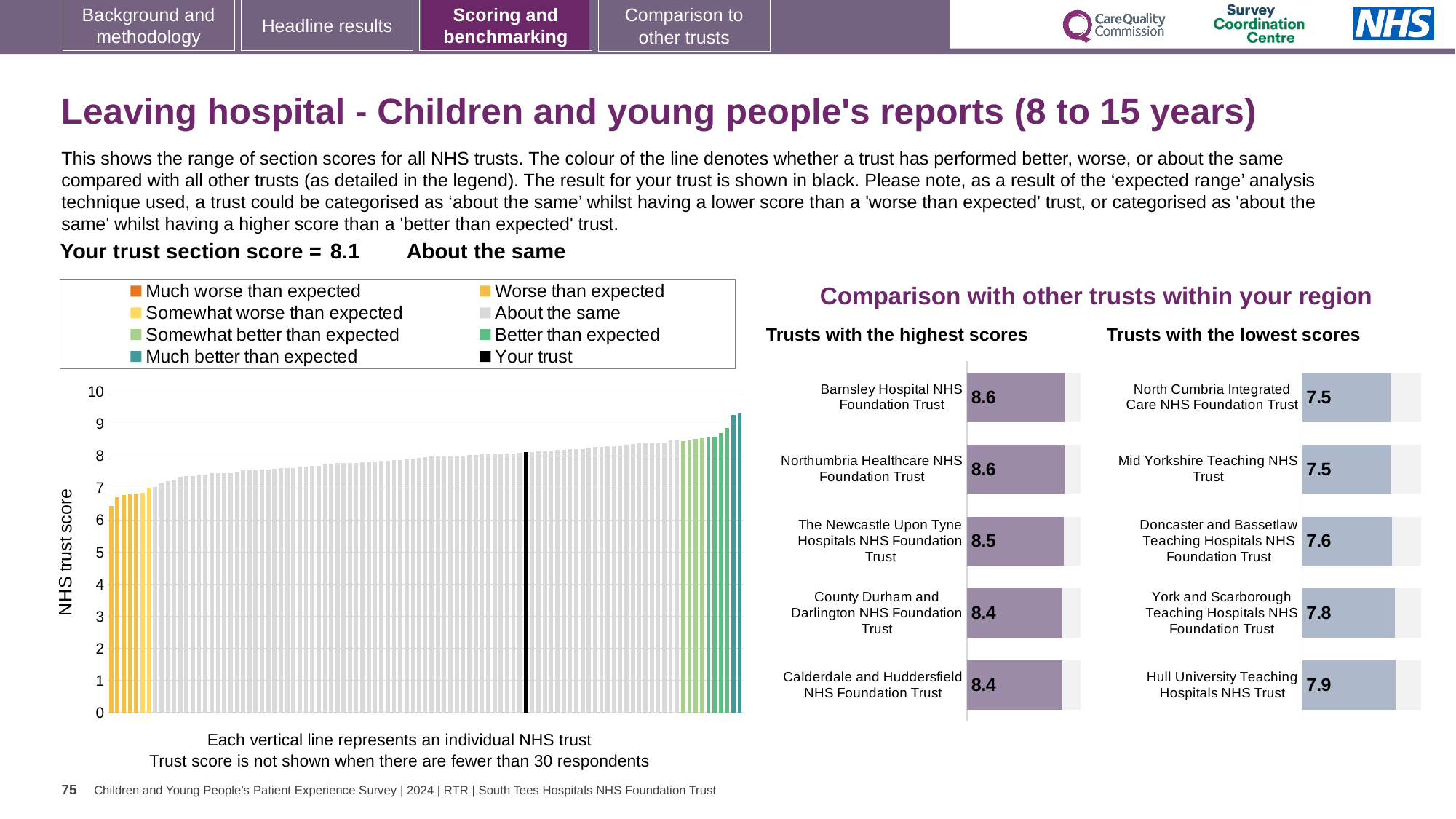
In the large chart on the left showing all NHS trusts, what is the section score for your trust (the black line)? 8.1 In the large chart on the left showing all NHS trusts, do the values rise or fall from left to right? rise In the 'Trusts with the lowest scores' chart, what is the score for York and Scarborough Teaching Hospitals NHS Foundation Trust? 7.8 In the large chart on the left showing all NHS trusts, is the value of the lowest bar greater or less than 7? less In the 'Trusts with the lowest scores' chart, which trust has the highest score? Hull University Teaching Hospitals NHS Trust In the 'Trusts with the lowest scores' chart, which has the larger score: Doncaster and Bassetlaw Teaching Hospitals NHS Foundation Trust or York and Scarborough Teaching Hospitals NHS Foundation Trust? York and Scarborough Teaching Hospitals NHS Foundation Trust In the 'Trusts with the highest scores' chart, what is the score for The Newcastle Upon Tyne Hospitals NHS Foundation Trust? 8.5 In the 'Trusts with the highest scores' chart, what is the score for Barnsley Hospital NHS Foundation Trust? 8.6 How many entries does the legend of the large chart on the left list? 8 What kind of chart is the 'Trusts with the lowest scores' chart? bar chart How many trusts are shown in the 'Trusts with the highest scores' chart? 5 In the 'Trusts with the lowest scores' chart, what is the difference between the scores of Hull University Teaching Hospitals NHS Trust and North Cumbria Integrated Care NHS Foundation Trust? 0.4